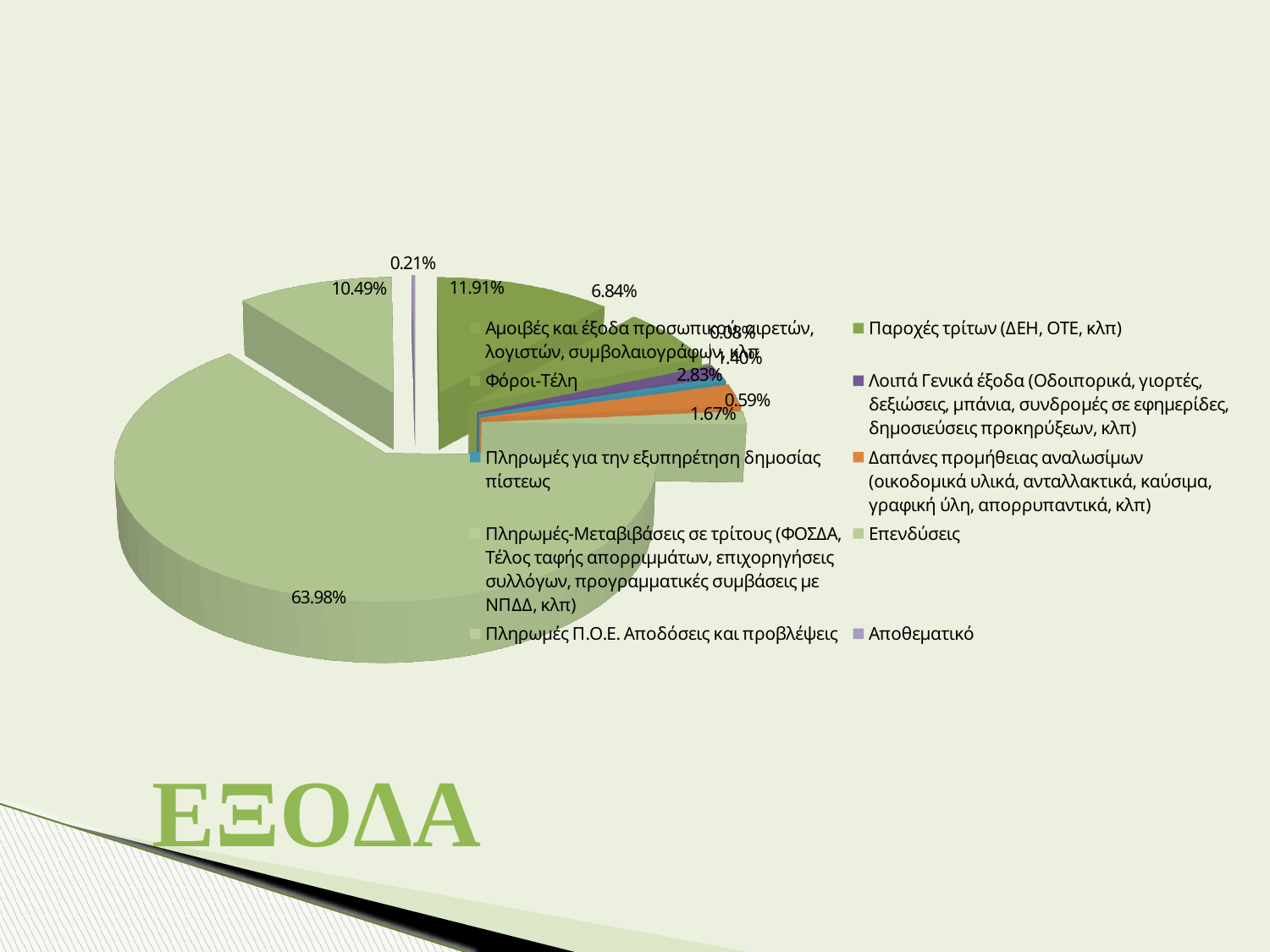
What is the share of the smallest slice in the pie chart? 0.08% What kind of chart is shown on the slide? pie chart Is the largest slice of the pie chart greater or less than 50%? greater What is the difference between the 2.83% slice and the 1.67% slice in the pie chart? 1.16% How many categories does the legend of the pie chart list? 10 What is the title shown on the slide for the chart? ΕΞΟΔΑ Which is larger in the pie chart: the 6.84% slice or the 10.49% slice? 10.49% What is the share of the largest slice in the pie chart? 63.98% How many slices in the pie chart have a share below 1%? 3 What is the difference between the largest slice (63.98%) and the second-largest slice (11.91%) in the pie chart? 52.07% What is the combined share of the 10.49% and 11.91% slices in the pie chart? 22.40%